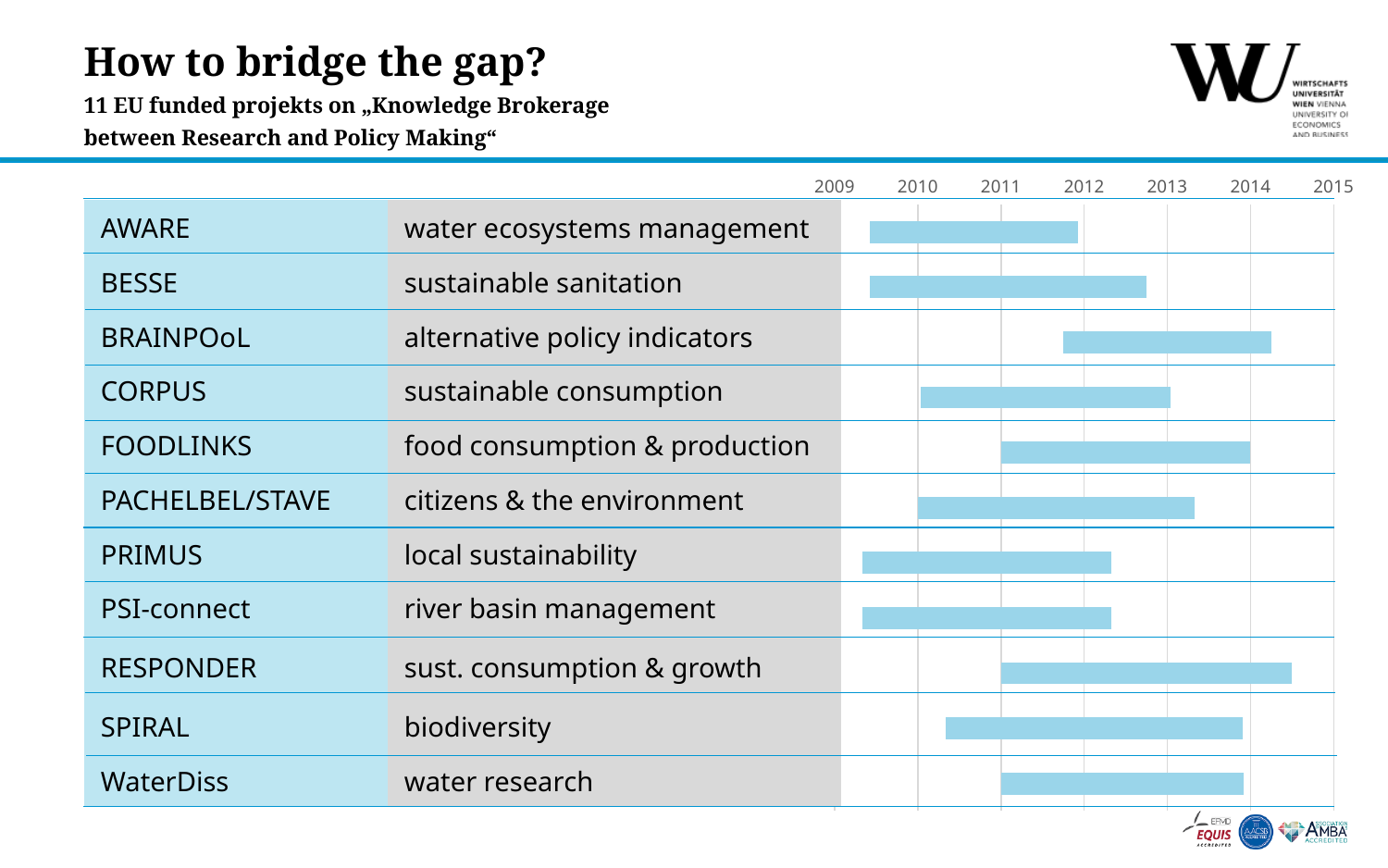
Does the PACHELBEL/STAVE bar end before or after 2013? after Which project starts earlier, AWARE or CORPUS? AWARE What topic is listed for the SPIRAL project? biodiversity What kind of chart is shown on the slide? bar chart (Gantt timeline) Does the PRIMUS bar start before or after 2010? before Which project's bar starts latest on the timeline? BRAINPOoL Does the AWARE bar start before or after 2009? after Which project's bar ends latest on the timeline? RESPONDER How many projects are listed in the chart? 11 Which project ends later, RESPONDER or AWARE? RESPONDER How many year labels are shown along the top axis? 7